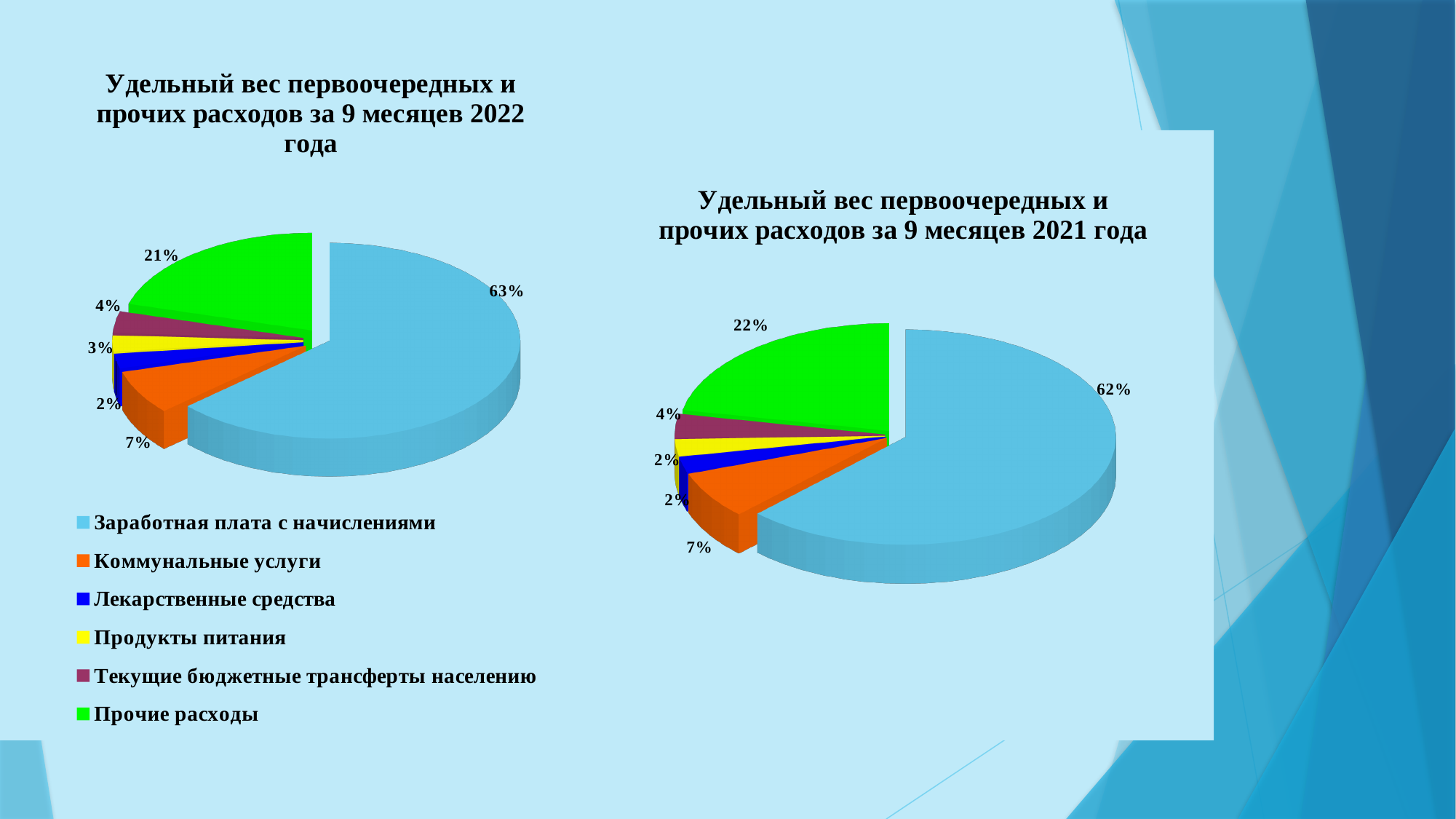
In the left chart (9 месяцев 2022 года), which category has the smallest share? Лекарственные средства In the left chart (9 месяцев 2022 года), what share does 'Коммунальные услуги' have? 7% What type of chart is the left chart, 'Удельный вес первоочередных и прочих расходов за 9 месяцев 2022 года'? Pie chart Which is larger: the share of the largest slice in the left chart (2022) or in the right chart (2021)? Left chart (2022), 63% In the right chart (9 месяцев 2021 года), what share does the green slice have? 22% What colour represents 'Прочие расходы' in the legend? Green How many categories does the legend on the slide list? 6 In the left chart (9 месяцев 2022 года), what share does 'Прочие расходы' have? 21% In the left chart (9 месяцев 2022 года), what is the difference between the shares of 'Прочие расходы' and 'Коммунальные услуги'? 14% In the left chart (9 месяцев 2022 года), what share does 'Заработная плата с начислениями' have? 63% In the right chart (9 месяцев 2021 года), what share does the largest light-blue slice have? 62% In the left chart (9 месяцев 2022 года), which category has the largest share? Заработная плата с начислениями